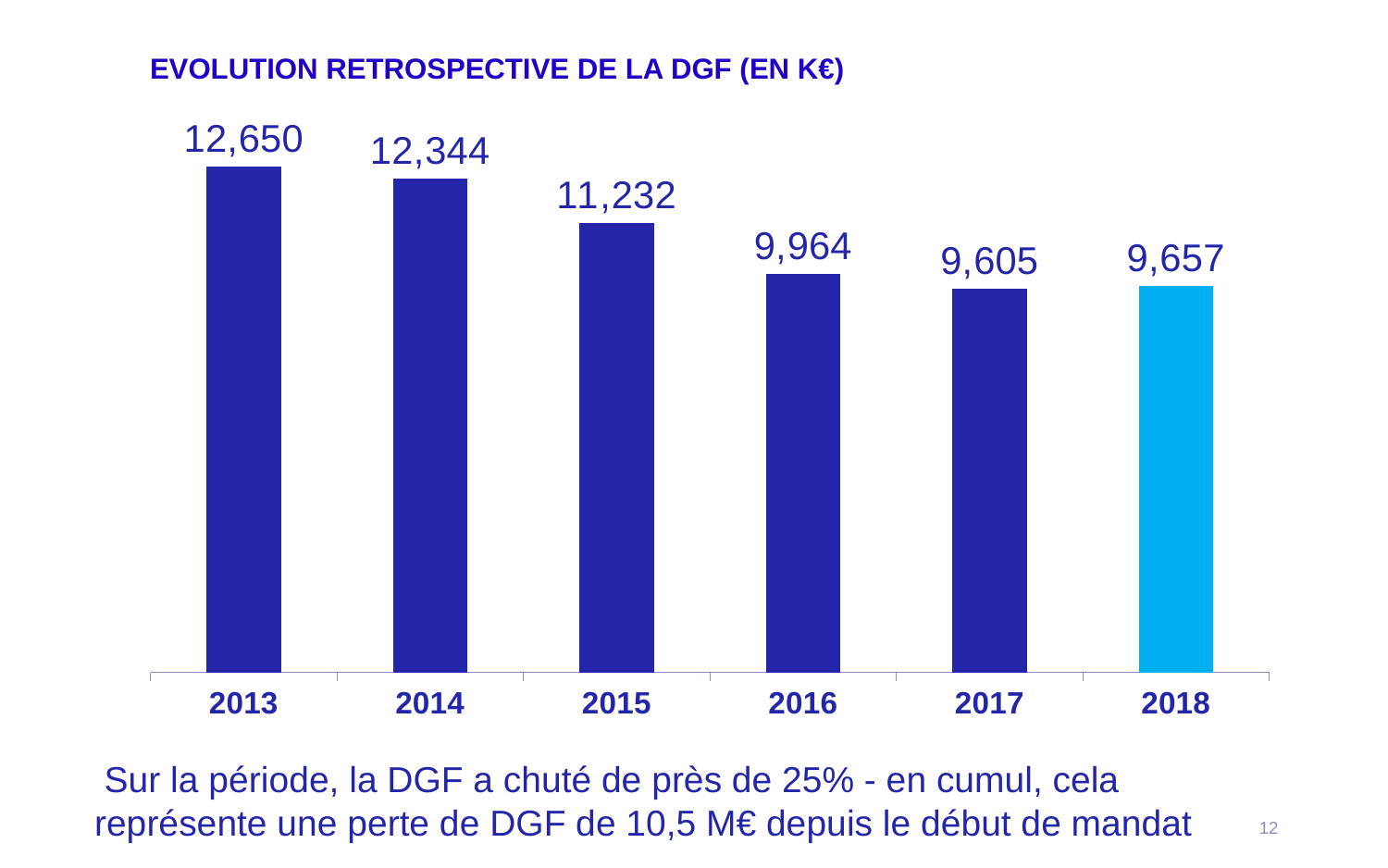
What kind of chart is shown on the slide? Bar chart Do the DGF values generally rise or fall from 2013 to 2017? Fall Which year has the highest DGF value? 2013 What is the difference between the DGF values for 2014 and 2015? 1,112 Which year has a larger DGF value, 2015 or 2016? 2015 What is the DGF value for 2013? 12,650 What is the DGF value for 2018? 9,657 How many years are shown on the chart? 6 What is the difference between the DGF values for 2013 and 2018? 2,993 What is the DGF value for 2016? 9,964 What is the title of the chart? EVOLUTION RETROSPECTIVE DE LA DGF (EN K€) Which year has the lowest DGF value? 2017